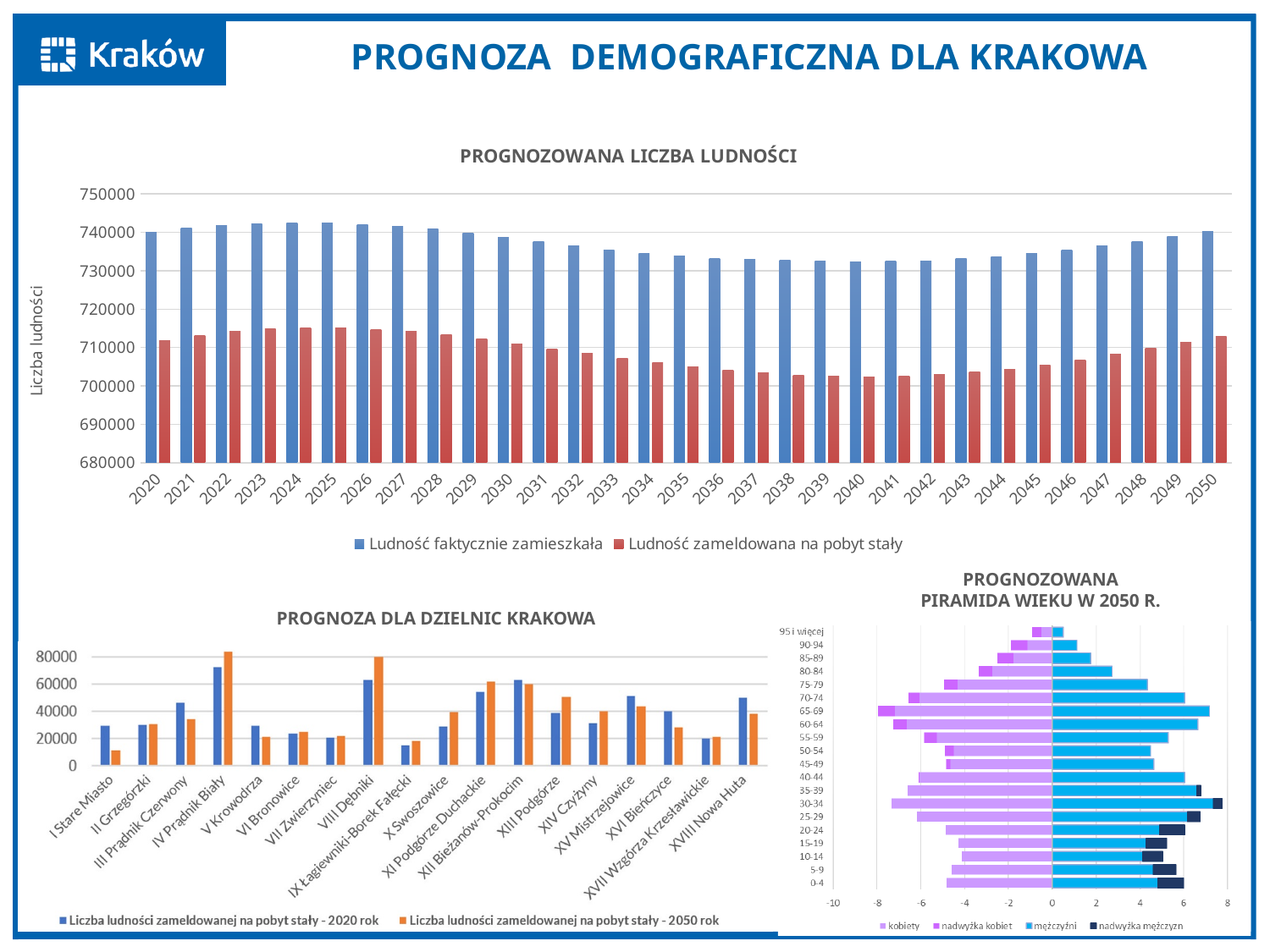
In the 'PROGNOZA DLA DZIELNIC KRAKOWA' chart, is the 2050 value for IV Prądnik Biały greater or less than 80000? greater In the 'PROGNOZOWANA LICZBA LUDNOŚCI' chart, does 'Ludność faktycznie zamieszkała' rise or fall between 2025 and 2040? fall What type of chart is the 'PROGNOZOWANA LICZBA LUDNOŚCI' chart? bar chart In the 'PROGNOZOWANA LICZBA LUDNOŚCI' chart, is the value of 'Ludność zameldowana na pobyt stały' for 2040 greater or less than 710000? less In the 'PROGNOZA DLA DZIELNIC KRAKOWA' chart, which district has the highest value for 2020? IV Prądnik Biały In the 'PROGNOZA DLA DZIELNIC KRAKOWA' chart, which district has the lowest value for 2050? I Stare Miasto In the 'PROGNOZOWANA LICZBA LUDNOŚCI' chart, which series has the larger value in 2030: 'Ludność faktycznie zamieszkała' or 'Ludność zameldowana na pobyt stały'? Ludność faktycznie zamieszkała In the 'PROGNOZOWANA LICZBA LUDNOŚCI' chart, is the value of 'Ludność faktycznie zamieszkała' for 2020 greater or less than 730000? greater How many series does the legend of the 'PROGNOZOWANA LICZBA LUDNOŚCI' chart list? 2 How many districts are shown on the x axis of the 'PROGNOZA DLA DZIELNIC KRAKOWA' chart? 18 How many entries does the legend of the 'PROGNOZOWANA PIRAMIDA WIEKU W 2050 R.' chart list? 4 How many years are shown on the x axis of the 'PROGNOZOWANA LICZBA LUDNOŚCI' chart? 31